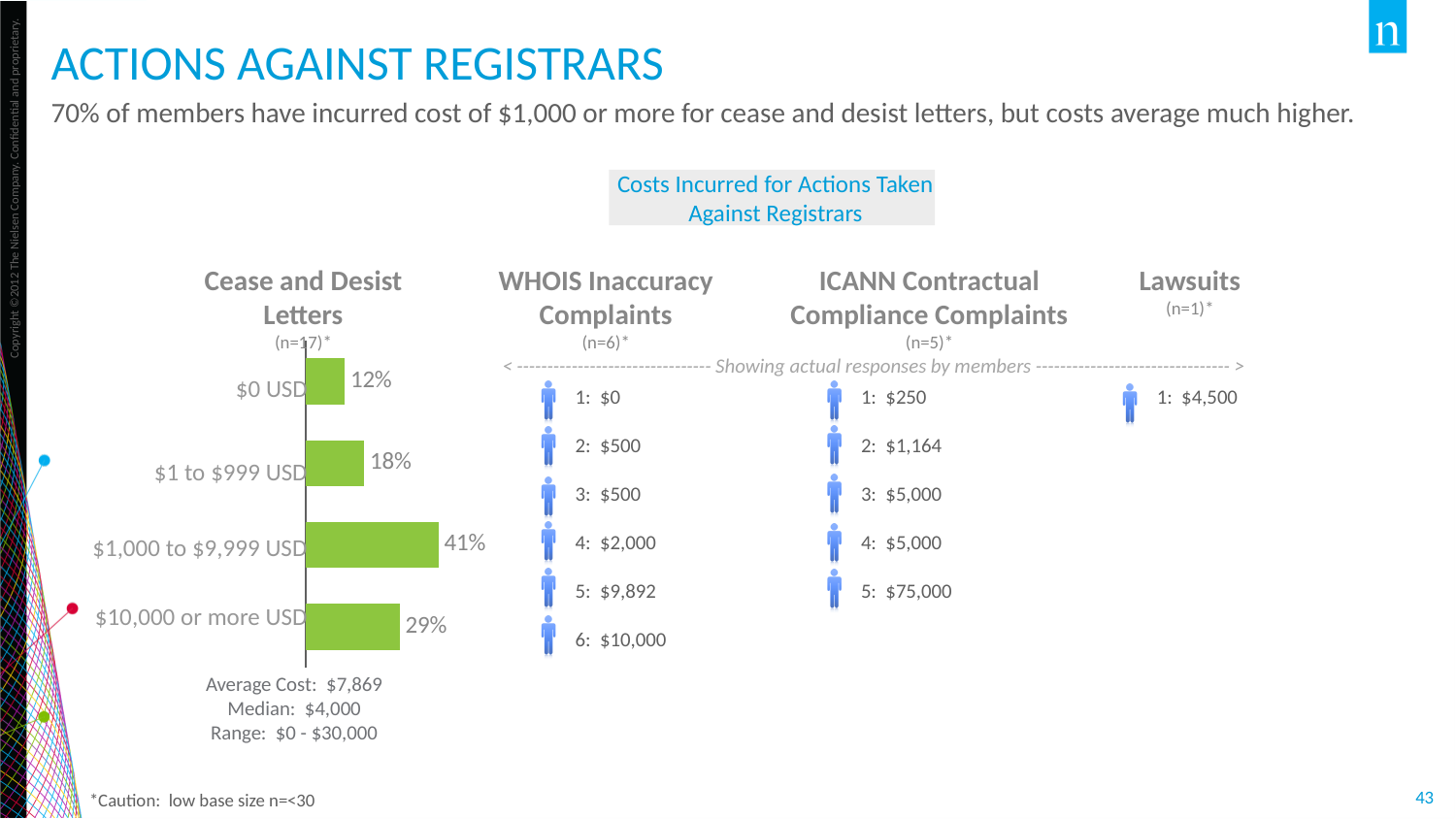
In the Cease and Desist Letters chart, which cost category has the highest percentage? $1,000 to $9,999 USD In the Cease and Desist Letters chart, what percentage of members incurred a cost of $0 USD? 12% In the Cease and Desist Letters chart, what is the difference in percentage points between the $1,000 to $9,999 USD category and the $10,000 or more USD category? 12 What is the average cost shown below the Cease and Desist Letters chart? $7,869 In the Cease and Desist Letters chart, what percentage of members incurred a cost of $10,000 or more USD? 29% How many cost categories are shown in the Cease and Desist Letters chart? 4 What type of chart is used for the Cease and Desist Letters data? Bar chart In the Cease and Desist Letters chart, what percentage of members incurred a cost of $1 to $999 USD? 18% What is the base size (n) noted for the Cease and Desist Letters chart? n=17 In the Cease and Desist Letters chart, what percentage of members incurred a cost of $1,000 to $9,999 USD? 41% In the Cease and Desist Letters chart, which is larger: the percentage for $1 to $999 USD or the percentage for $10,000 or more USD? $10,000 or more USD In the Cease and Desist Letters chart, which cost category has the lowest percentage? $0 USD